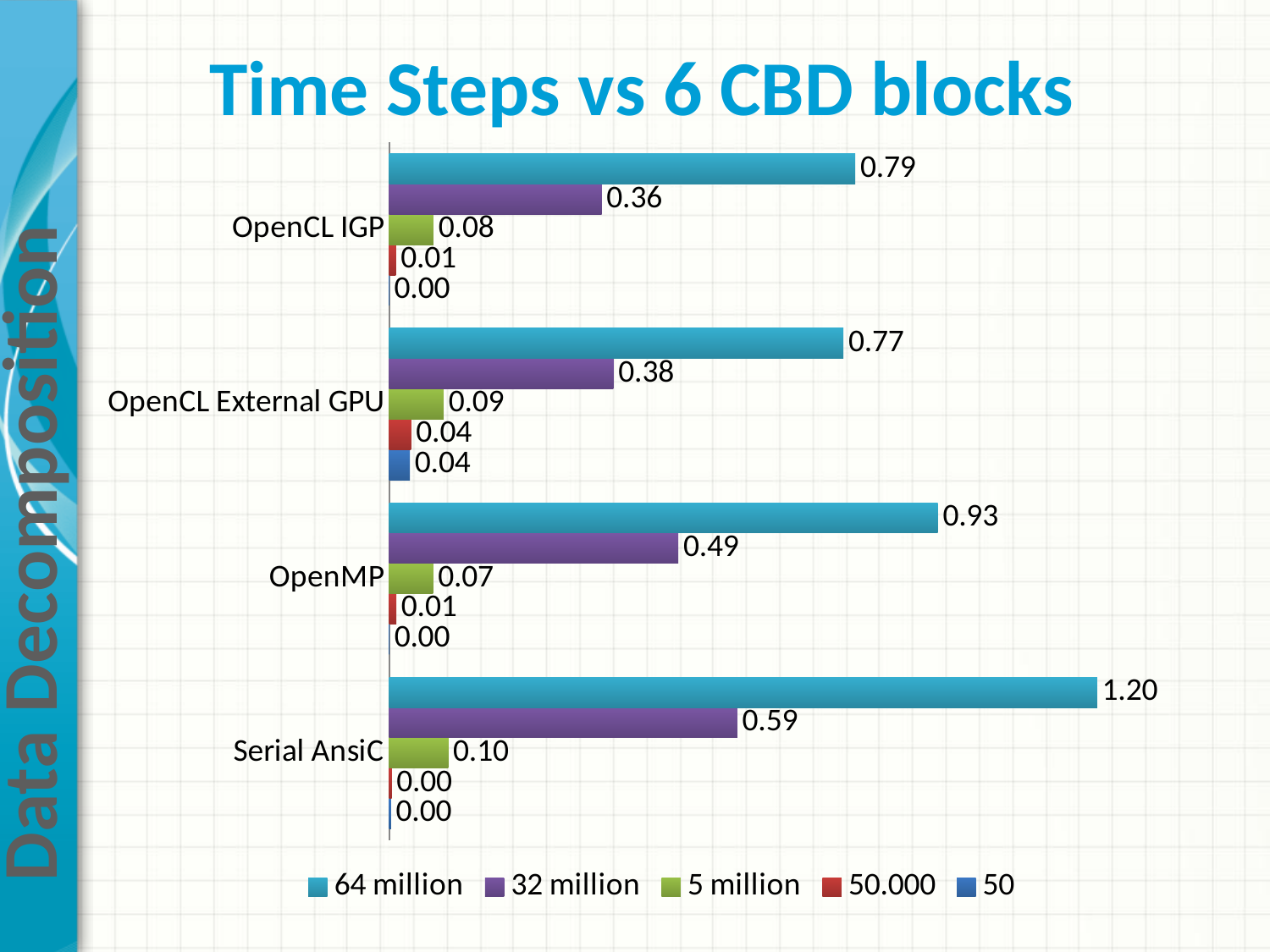
Which category has the highest value in the 64 million series? Serial AnsiC What kind of chart is shown on the slide? Bar chart Which is larger in the 32 million series: OpenMP or OpenCL External GPU? OpenMP What is the difference between the 64 million values for Serial AnsiC and OpenMP? 0.27 Which category has the lowest value in the 32 million series? OpenCL IGP What is the value for OpenMP in the 5 million series? 0.07 What is the value for OpenCL External GPU in the 50 series? 0.04 What is the title of the chart? Time Steps vs 6 CBD blocks How many categories are shown on the chart? 4 How many series does the legend list? 5 What is the value for Serial AnsiC in the 64 million series? 1.20 What is the value for OpenCL External GPU in the 32 million series? 0.38